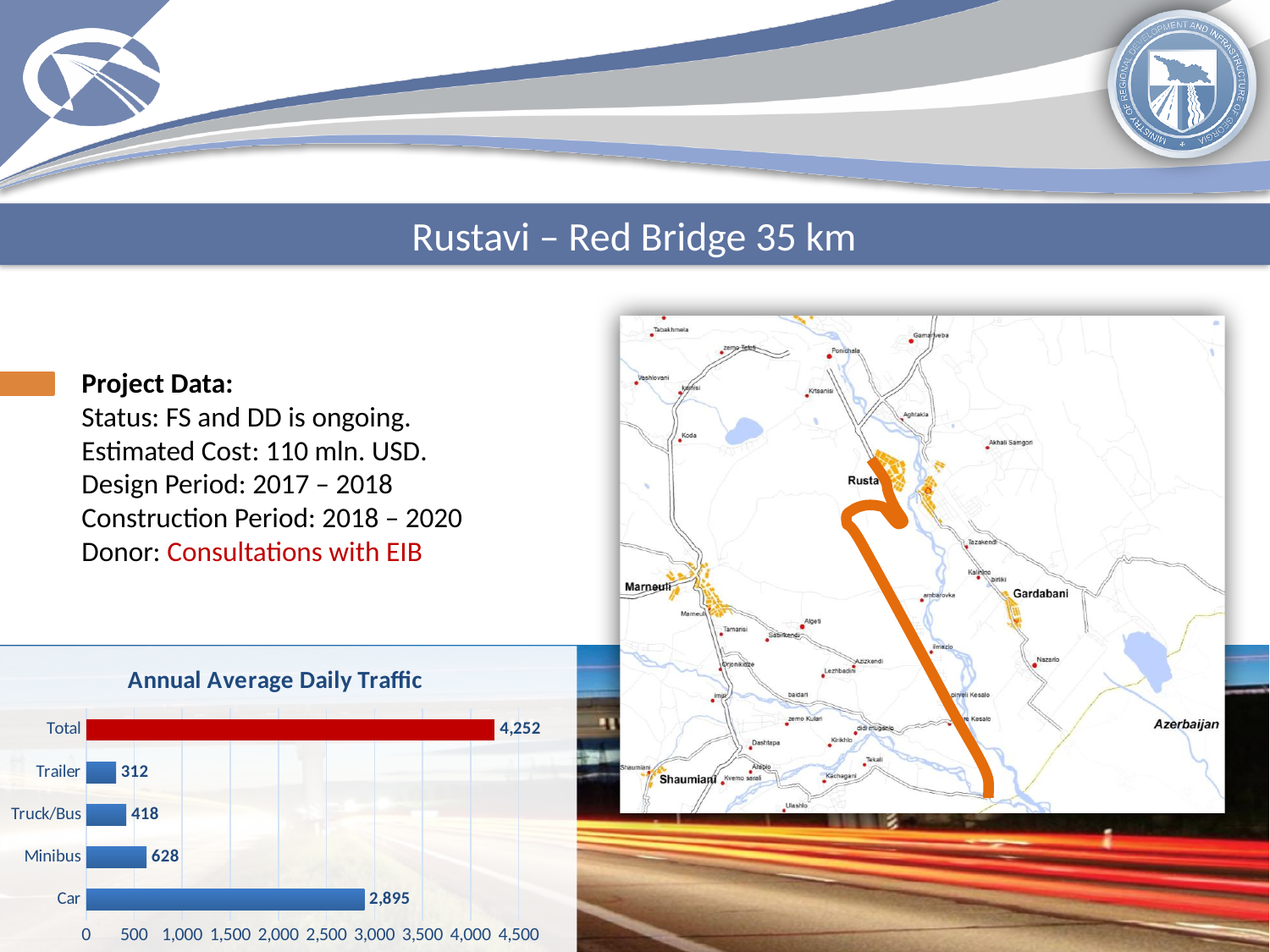
Which is larger in the Annual Average Daily Traffic chart, Truck/Bus or Minibus? Minibus Excluding the Total bar, which vehicle category has the highest annual average daily traffic? Car What is the value for Minibus in the Annual Average Daily Traffic chart? 628 What is the value for Car in the Annual Average Daily Traffic chart? 2,895 What is the value for Trailer in the Annual Average Daily Traffic chart? 312 What kind of chart is the Annual Average Daily Traffic chart? Bar chart What is the difference between the Car and Minibus values in the Annual Average Daily Traffic chart? 2,267 Which vehicle category has the lowest annual average daily traffic? Trailer How many categories (bars) are shown in the Annual Average Daily Traffic chart? 5 What colour is the Total bar in the Annual Average Daily Traffic chart? Red What is the Total value shown in the Annual Average Daily Traffic chart? 4,252 What is the value for Truck/Bus in the Annual Average Daily Traffic chart? 418